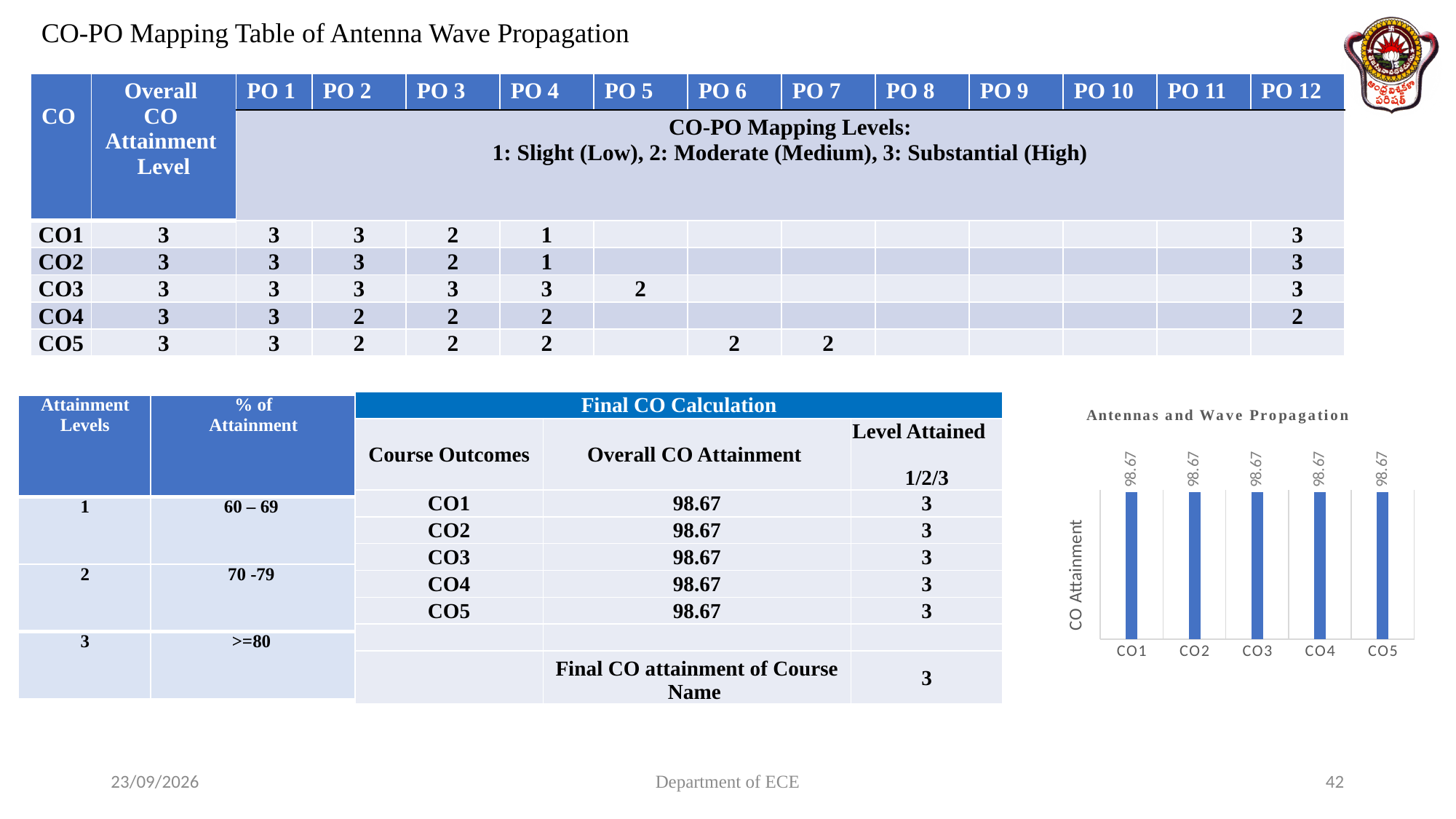
How many categories are shown on the x axis of the chart? 5 Do the values rise, fall, or stay the same from CO1 to CO5 in the chart? stay the same What is the value for CO5 in the chart? 98.67 Is the value for CO4 in the chart greater or less than 90? greater What is the difference between the values for CO2 and CO4 in the chart? 0 What is the value for CO1 in the chart? 98.67 What is the label on the vertical axis of the chart? CO Attainment What is the value for CO3 in the chart? 98.67 What kind of chart is shown on the slide? bar chart What is the title of the chart? Antennas and Wave Propagation